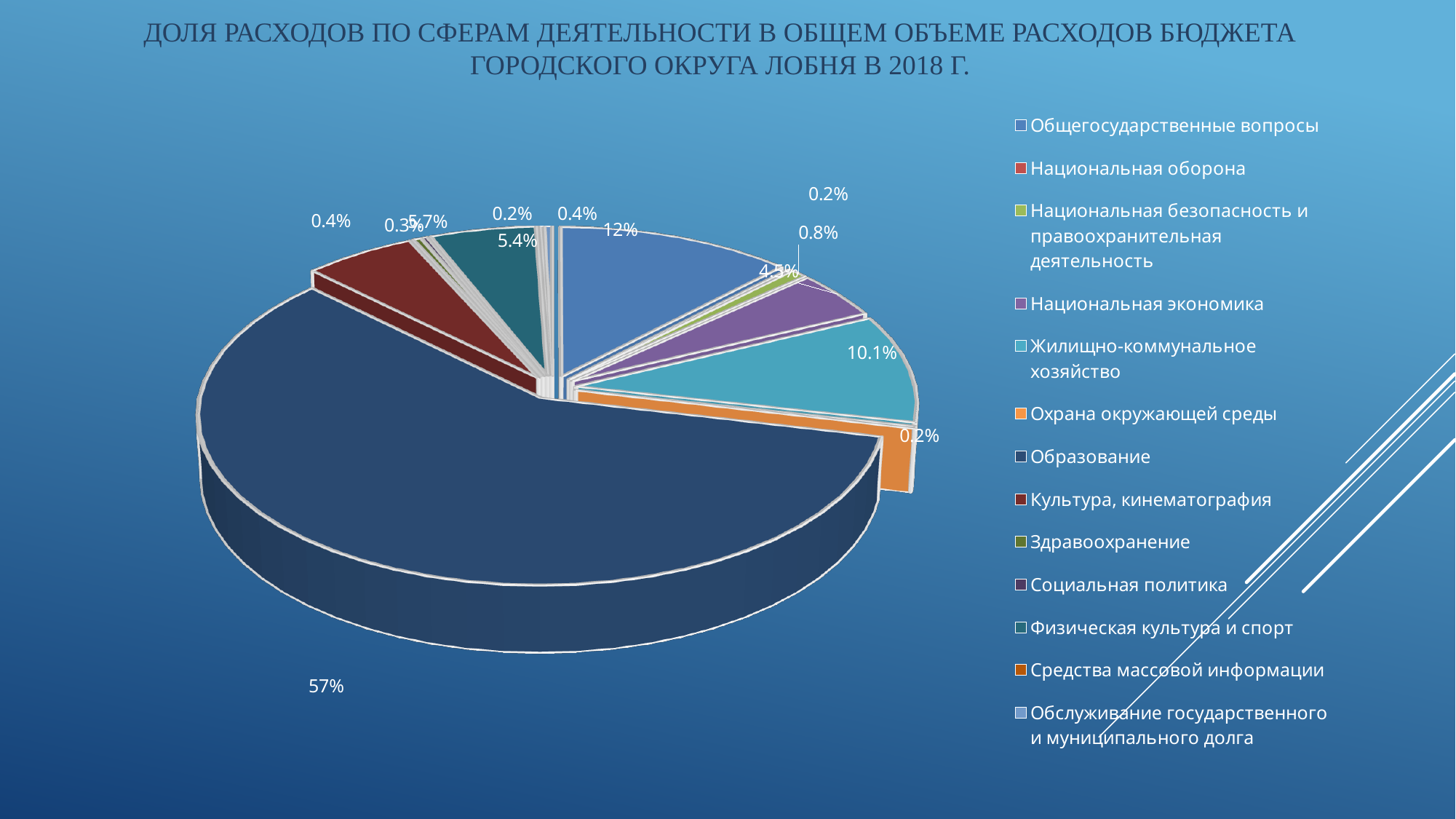
How many categories does the legend list? 13 What share of expenditures is shown for Образование? 57% What share is shown for Национальная безопасность и правоохранительная деятельность? 0.8% What share is shown for Общегосударственные вопросы? 12% Which category has the largest share of the pie? Образование What is the difference between the shares for Общегосударственные вопросы and Жилищно-коммунальное хозяйство? 1.9% What share is shown for Жилищно-коммунальное хозяйство? 10.1% What kind of chart is shown on the slide? pie chart Which year does the chart title refer to? 2018 What share is shown for Национальная экономика? 4.5% Which category is listed first in the legend? Общегосударственные вопросы Which is larger: the share for Общегосударственные вопросы or for Жилищно-коммунальное хозяйство? Общегосударственные вопросы